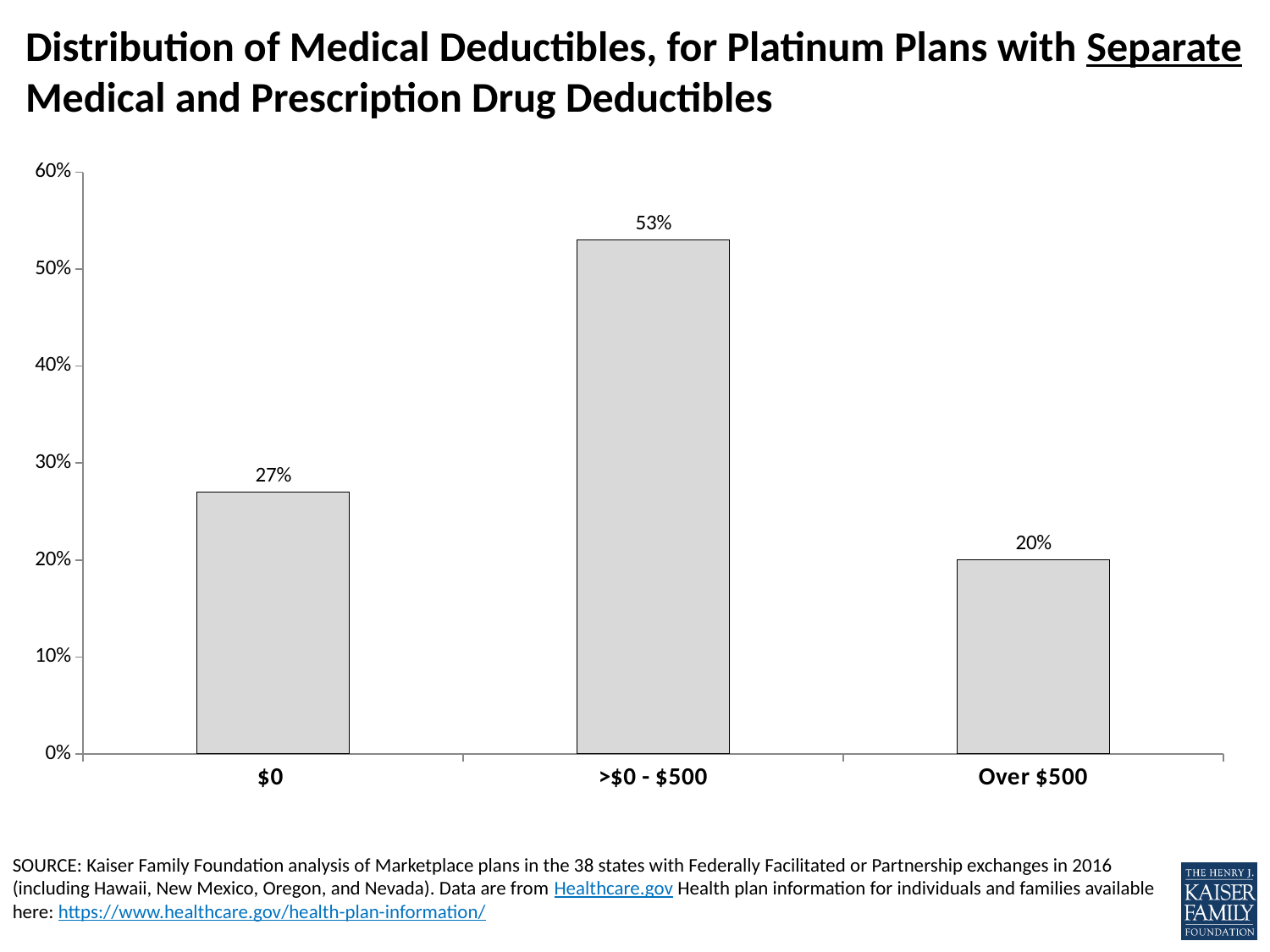
What is the value shown for the >$0 - $500 category? 53% What percentage of plans have a medical deductible of Over $500? 20% Which is larger, the share for $0 or the share for Over $500? $0 Is the value for >$0 - $500 greater or less than 50%? greater What percentage of platinum plans with separate deductibles have a $0 medical deductible? 27% Which deductible category has the highest share of plans? >$0 - $500 Which deductible category has the lowest share of plans? Over $500 What is the maximum value shown on the vertical axis? 60% What kind of chart is shown on the slide? Bar chart What is the difference between the $0 share and the Over $500 share? 7% What is the difference between the >$0 - $500 share and the $0 share? 26% How many deductible categories are shown on the chart? 3